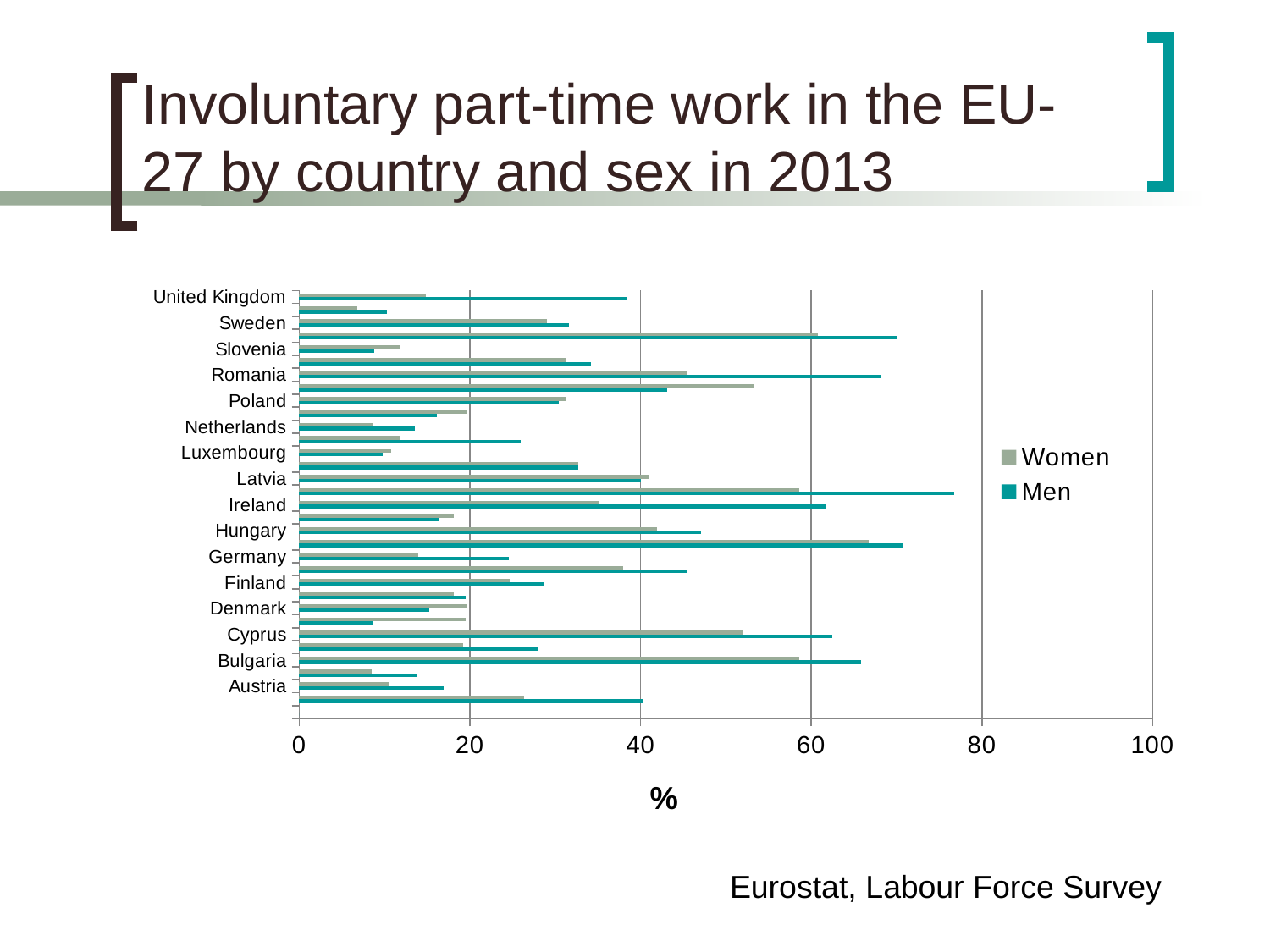
What are the two series named in the legend? Women and Men What kind of chart is shown on the slide? bar chart Is the value for Women in Germany greater or less than 20? less What label is shown on the horizontal axis? % In Ireland, which is larger, the value for Men or the value for Women? Men How many series does the legend list? 2 Is the value for Women in Cyprus greater or less than 40? greater Is the value for Men in Bulgaria greater or less than 60? greater In Romania, which is larger, the value for Men or the value for Women? Men